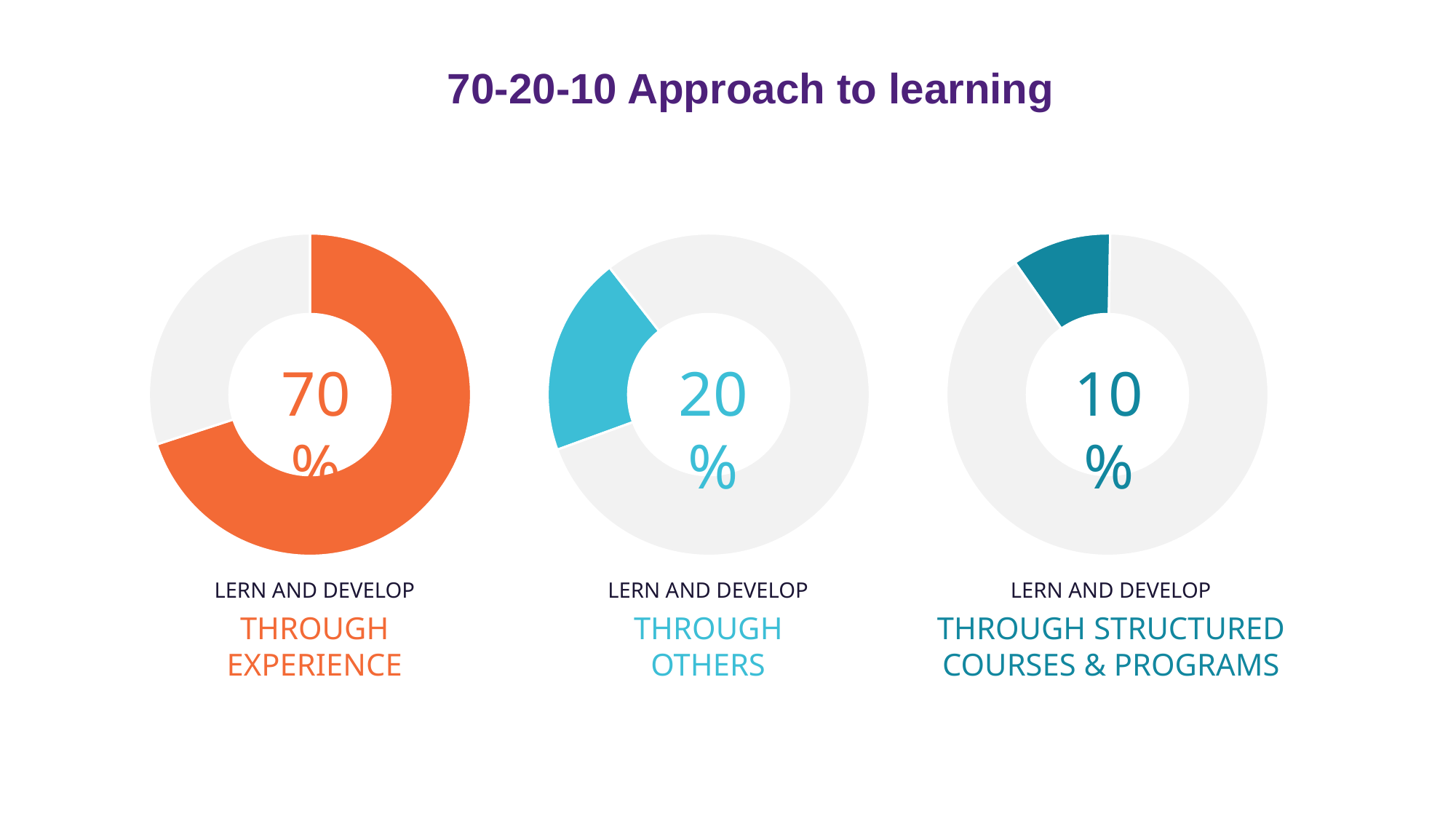
What percentage is shown in the left donut chart labelled 'Through Experience'? 70% What kind of chart is used to show each percentage on the slide? Donut (pie) chart Which of the three donut charts shows the highest percentage? Through Experience What percentage is shown in the middle donut chart labelled 'Through Others'? 20% What percentage is shown in the right donut chart labelled 'Through Structured Courses & Programs'? 10% What is the total of the three percentages shown across the donut charts? 100% How many donut charts are on the slide? 3 What is the difference between the percentage for 'Through Others' and the percentage for 'Through Structured Courses & Programs'? 10% What is the title of the slide? 70-20-10 Approach to learning What is the difference between the percentage for 'Through Experience' and the percentage for 'Through Others'? 50% Which of the three donut charts shows the lowest percentage? Through Structured Courses & Programs Which is larger: the percentage for 'Through Others' or the percentage for 'Through Structured Courses & Programs'? Through Others